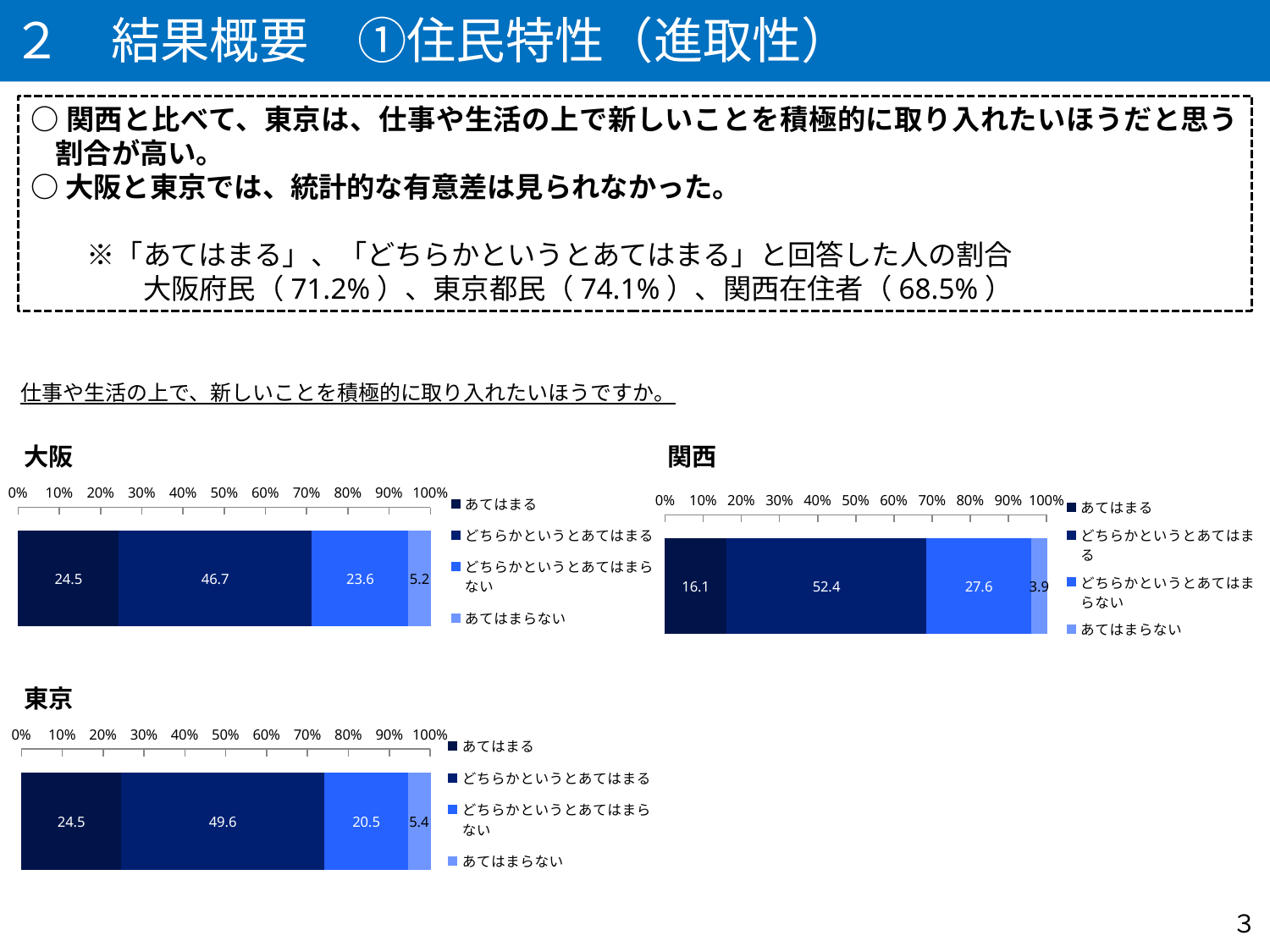
In the 関西 chart, is the value for どちらかというとあてはまる greater or less than 50%? greater In the 大阪 chart, what is the value for どちらかというとあてはまる? 46.7 In the 東京 chart, which category has the highest value? どちらかというとあてはまる What is the difference between the あてはまる values in the 大阪 chart and the 関西 chart? 8.4 How many series does the legend of the 東京 chart list? 4 What kind of chart is the 大阪 chart? stacked bar chart In the 大阪 chart, which category has the lowest value? あてはまらない In the 東京 chart, what is the combined value of あてはまる and どちらかというとあてはまる? 74.1 In the 関西 chart, what is the value for あてはまる? 16.1 Which is larger: the どちらかというとあてはまる value in the 東京 chart or in the 大阪 chart? 東京 In the 東京 chart, what is the value for どちらかというとあてはまらない? 20.5 In the 関西 chart, what is the value for あてはまらない? 3.9